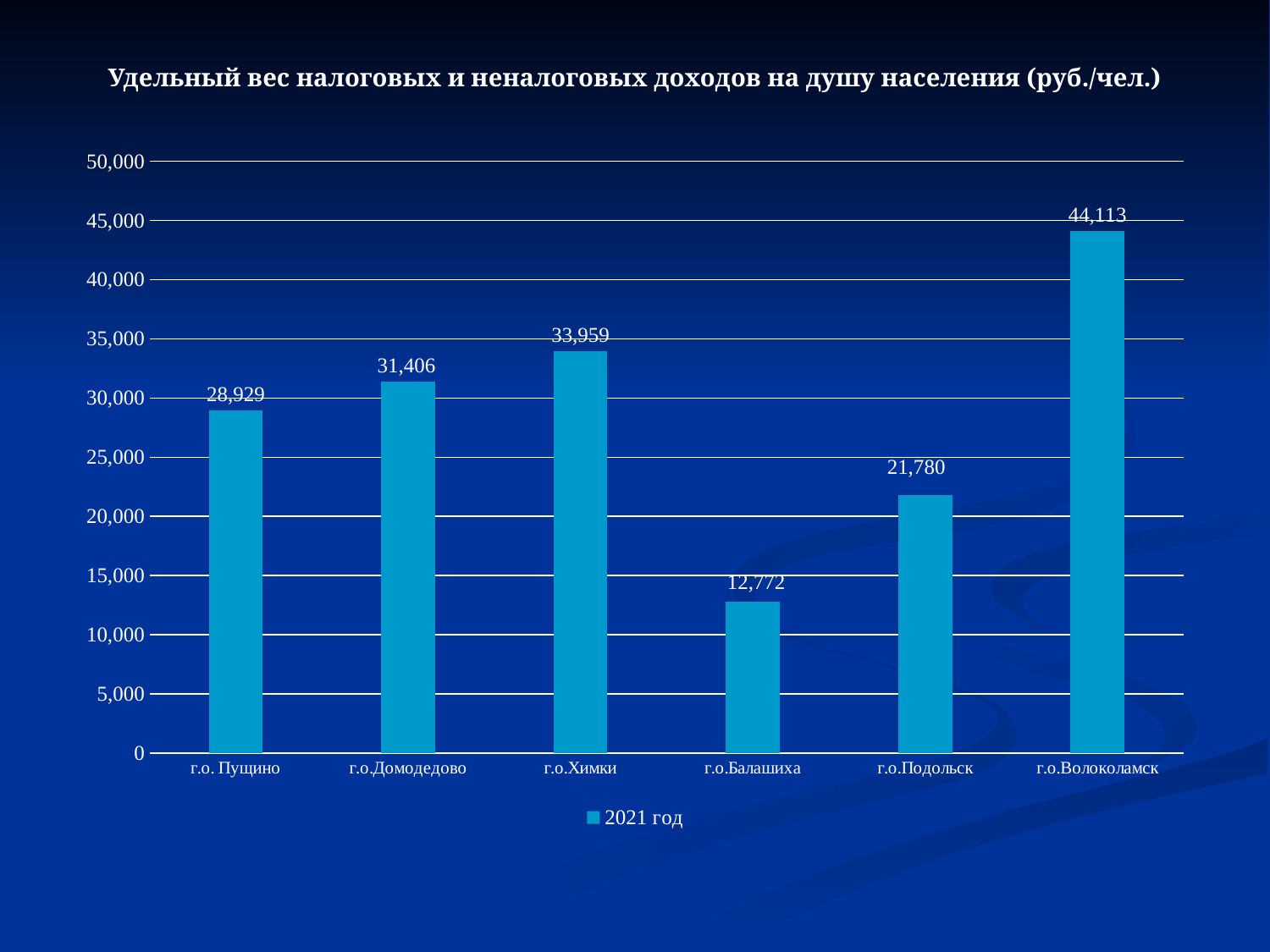
What is the value for г.о. Пущино? 28,929 How many categories are shown on the x axis? 6 What is the value for г.о.Подольск? 21,780 Which category has the highest value? г.о.Волоколамск What is the difference between the values for г.о.Волоколамск and г.о.Химки? 10,154 What kind of chart is shown on the slide? bar chart Is the value for г.о.Подольск greater or less than 25,000? less What series does the legend list? 2021 год What is the difference between the values for г.о.Домодедово and г.о. Пущино? 2,477 Which is larger, the value for г.о.Химки or the value for г.о.Домодедово? г.о.Химки Which category has the lowest value? г.о.Балашиха What is the value for г.о.Балашиха? 12,772